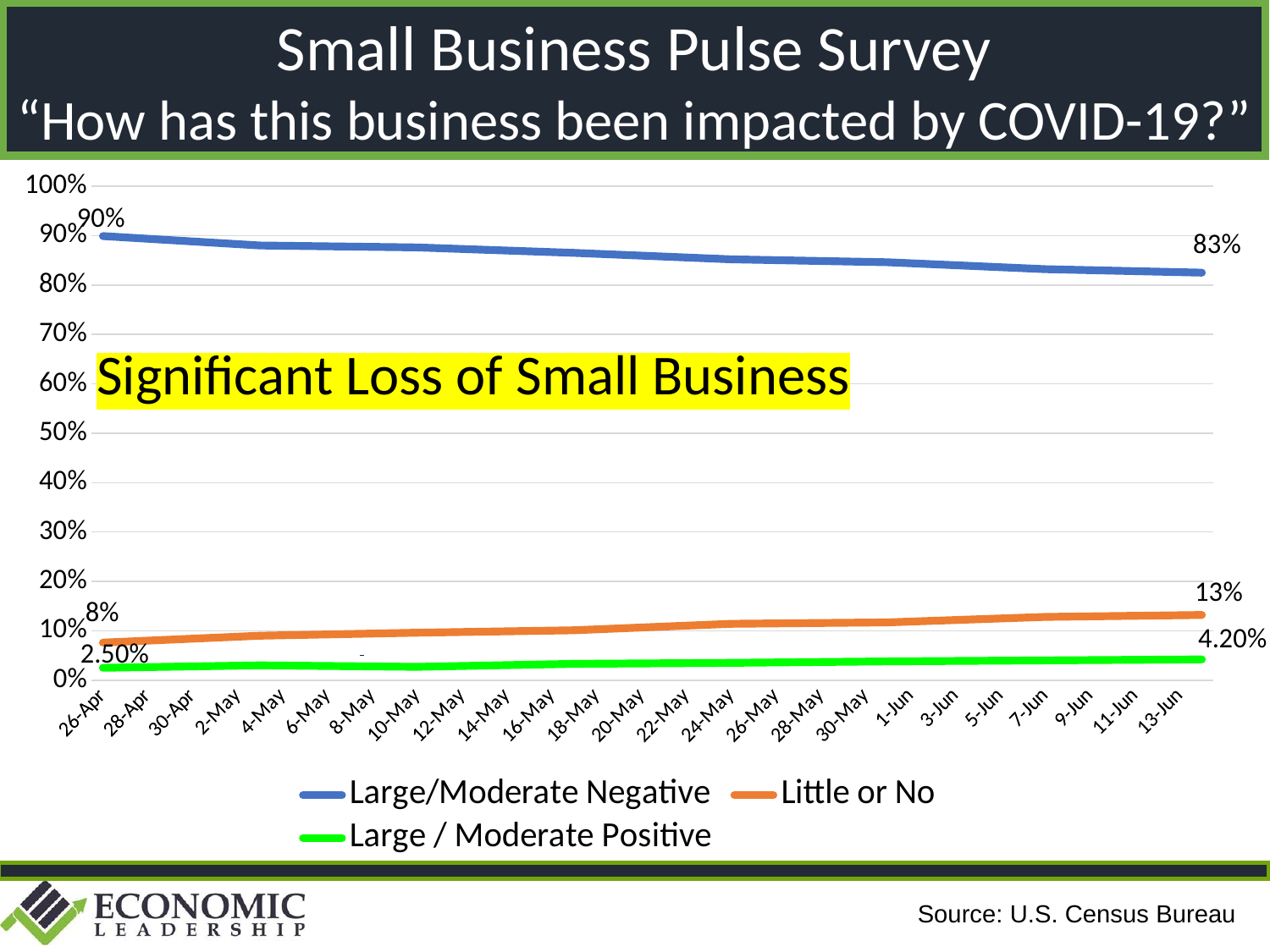
By how many percentage points did the Large/Moderate Negative series change between 26-Apr (90%) and 13-Jun (83%)? 7 percentage points What is the value of the Little or No series on 26-Apr? 8% What is the value of the Large/Moderate Negative series on 13-Jun? 83% What text is highlighted in yellow on the chart? Significant Loss of Small Business What is the value of the Large/Moderate Negative series on 26-Apr? 90% What is the value of the Little or No series on 13-Jun? 13% What kind of chart is shown on the slide? Line chart What is the value of the Large / Moderate Positive series on 13-Jun? 4.20% How many series does the legend list? 3 What is the value of the Large / Moderate Positive series on 26-Apr? 2.50% Does the Large/Moderate Negative series rise or fall from 26-Apr to 13-Jun? Fall Is the value of the Little or No series on 20-May greater or less than 20%? less